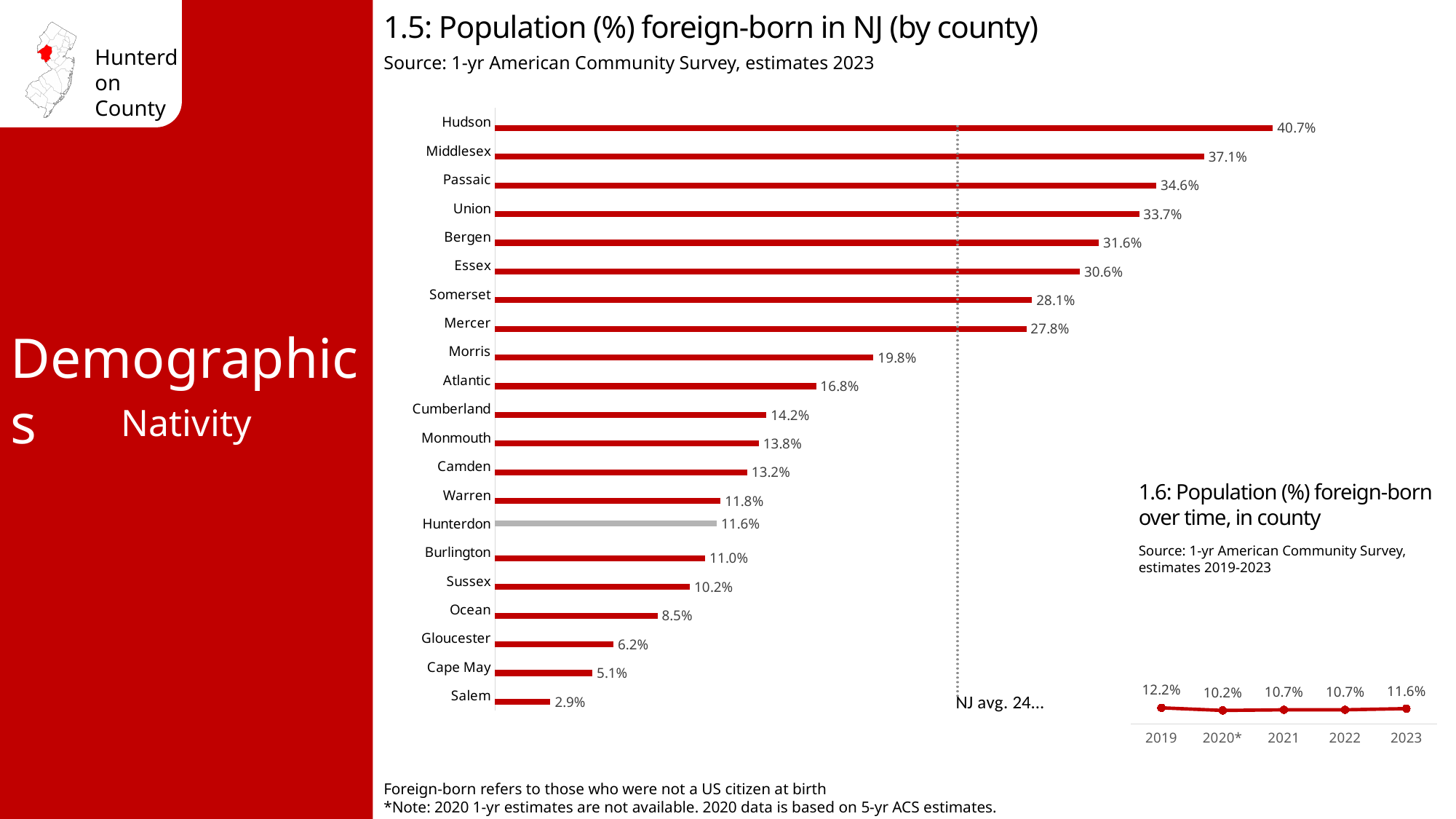
In chart 1.5 (Population (%) foreign-born in NJ by county), which county has the highest value? Hudson In chart 1.6 (Population (%) foreign-born over time, in county), what is the value for 2019? 12.2% In chart 1.5 (Population (%) foreign-born in NJ by county), what is the value for Hunterdon? 11.6% In chart 1.6 (Population (%) foreign-born over time, in county), which year has the lowest value? 2020* In chart 1.5 (Population (%) foreign-born in NJ by county), which is larger, Warren or Hunterdon? Warren What kind of chart is chart 1.6 (Population (%) foreign-born over time, in county)? Line chart In chart 1.5 (Population (%) foreign-born in NJ by county), what is the value for Bergen? 31.6% In chart 1.5 (Population (%) foreign-born in NJ by county), what is the difference between Hudson and Salem? 37.8% What kind of chart is chart 1.5 (Population (%) foreign-born in NJ by county)? Bar chart In chart 1.6 (Population (%) foreign-born over time, in county), what is the difference between 2023 and 2022? 0.9% In chart 1.5 (Population (%) foreign-born in NJ by county), which county has the lowest value? Salem In chart 1.5 (Population (%) foreign-born in NJ by county), how many counties are shown? 21